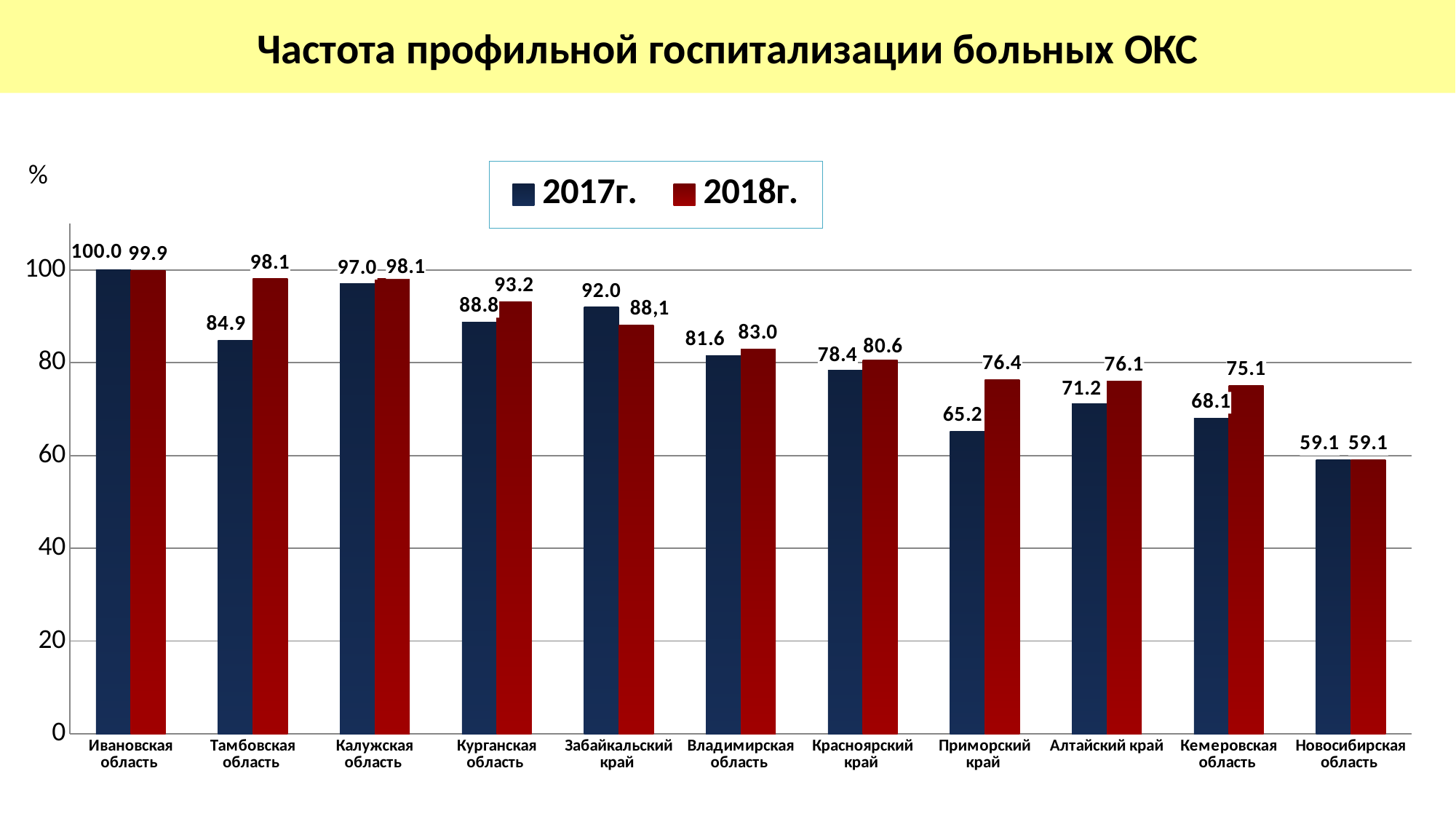
Which region has the highest 2017г. value? Ивановская область What kind of chart is shown on the slide? bar chart Which is larger for Забайкальский край, the 2017г. value or the 2018г. value? 2017г. Which region has the lowest 2018г. value? Новосибирская область What is the 2018г. value for Забайкальский край? 88,1 What is the difference between the 2018г. and 2017г. values for Тамбовская область? 13.2 What is the 2017г. value for Тамбовская область? 84.9 Is the 2017г. value for Кемеровская область greater or less than 80? less How many series does the legend list? 2 What is the 2018г. value for Приморский край? 76.4 How many regions are shown on the x axis? 11 What is the title of the chart? Частота профильной госпитализации больных ОКС